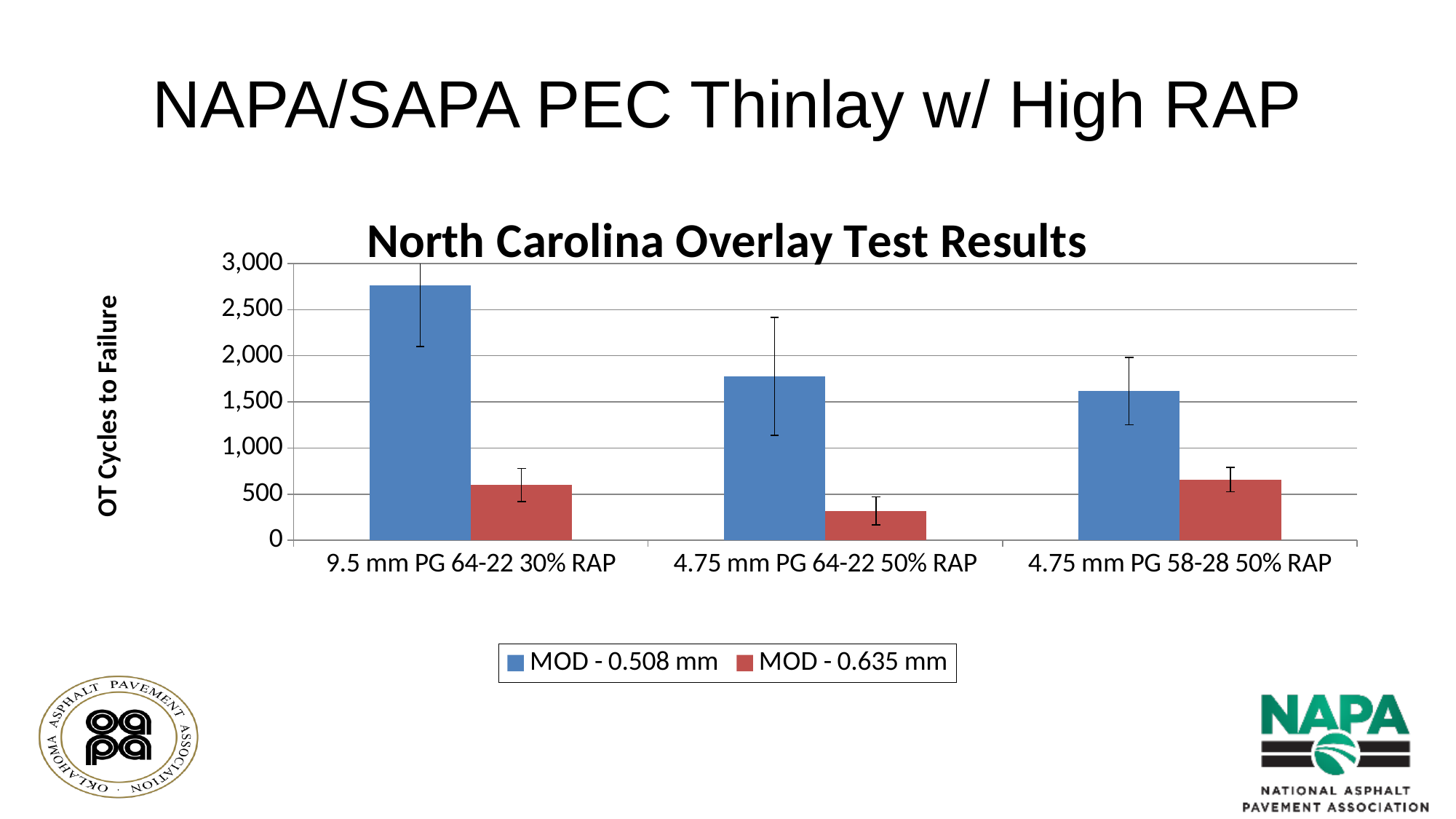
How many mix categories are shown on the x axis? 3 How many series does the legend list? 2 What type of chart is shown on the slide? bar chart What is the label of the y axis? OT Cycles to Failure Is the MOD - 0.508 mm value for 9.5 mm PG 64-22 30% RAP greater or less than 2,500? greater Which category has the highest MOD - 0.508 mm value? 9.5 mm PG 64-22 30% RAP Is the MOD - 0.508 mm value for 4.75 mm PG 58-28 50% RAP greater or less than 1,500? greater Is the MOD - 0.635 mm value for 9.5 mm PG 64-22 30% RAP greater or less than 1,000? less For 4.75 mm PG 64-22 50% RAP, which series has the larger value, MOD - 0.508 mm or MOD - 0.635 mm? MOD - 0.508 mm Which category has the lowest MOD - 0.635 mm value? 4.75 mm PG 64-22 50% RAP What is the title of the chart? North Carolina Overlay Test Results